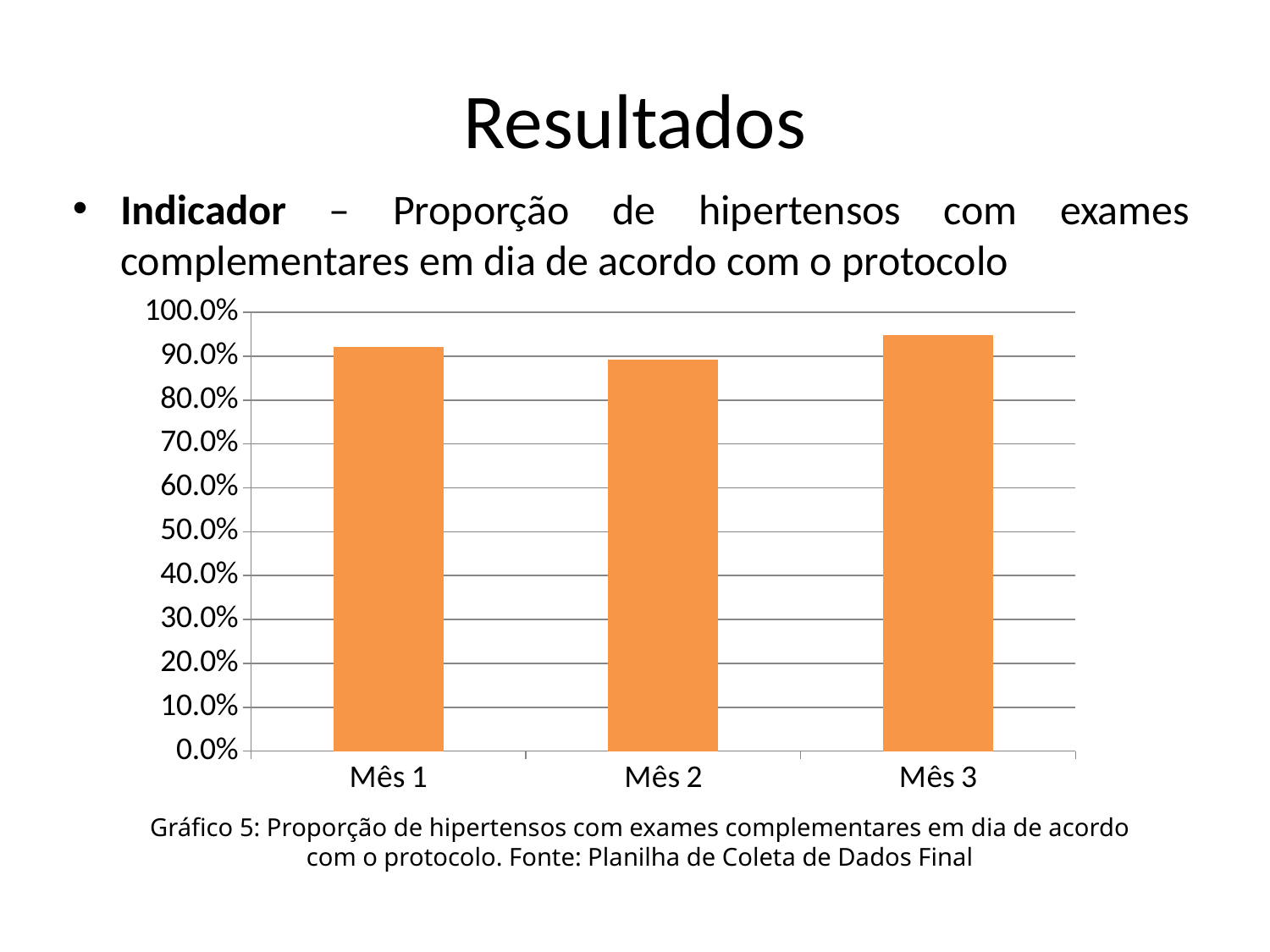
Is the value for Mês 1 greater or less than 90.0%? greater What is the number of the graph given in the caption below the chart? Gráfico 5 Which month has the highest proportion in the chart? Mês 3 Does the value rise or fall from Mês 2 to Mês 3? rise Is the value for Mês 3 greater or less than 100.0%? less What colour are the bars in the chart? orange How many months (categories) are plotted on the x axis of the chart? 3 What kind of chart is shown on the slide? bar chart Which month has the lowest proportion in the chart? Mês 2 Which is larger, the value for Mês 1 or the value for Mês 2? Mês 1 Is the value for Mês 2 greater or less than 90.0%? less